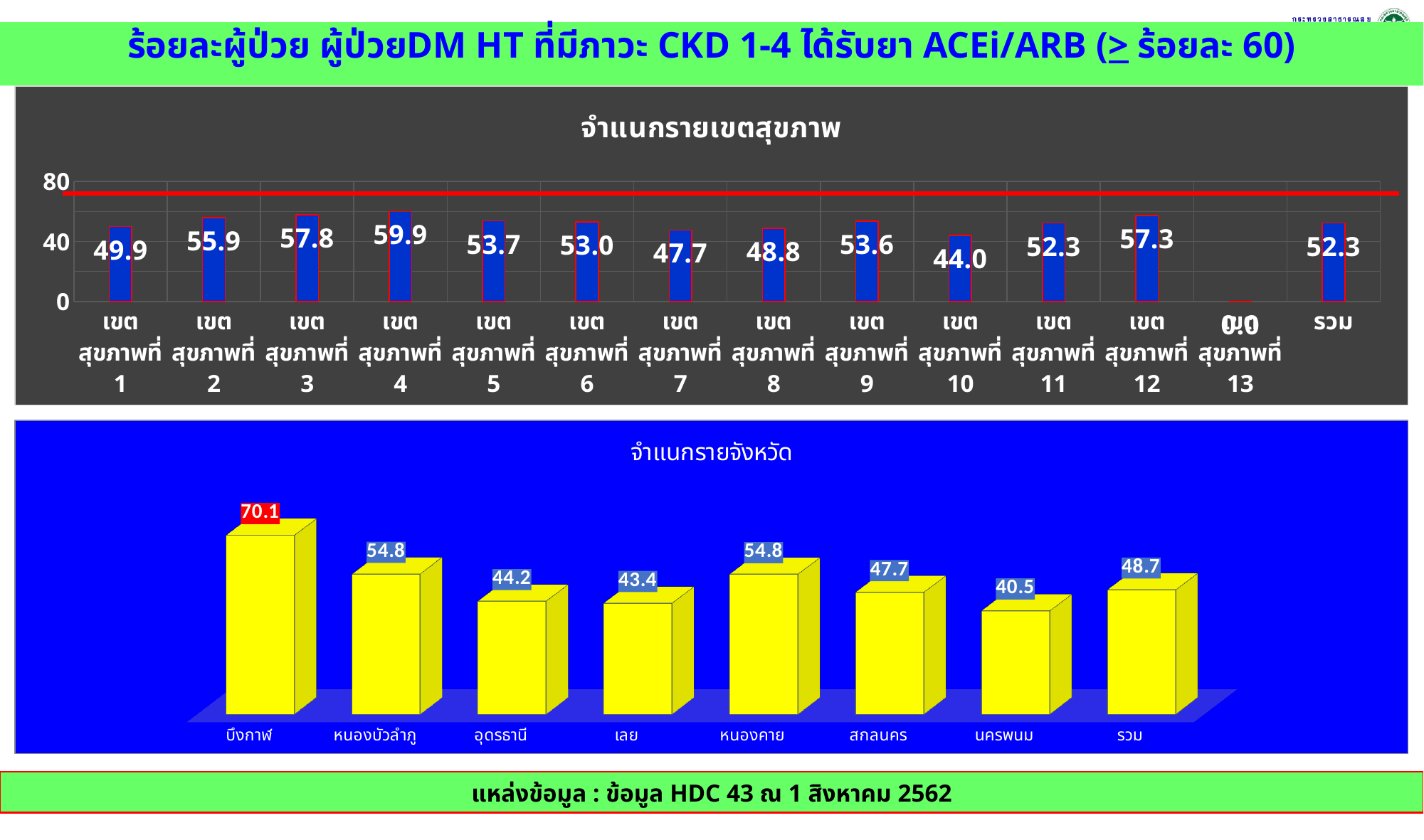
In the top chart (จำแนกรายเขตสุขภาพ), which health region (เขตสุขภาพที่ 1–12) has the lowest value? เขตสุขภาพที่ 10 In the top chart (จำแนกรายเขตสุขภาพ), what is the value for รวม? 52.3 In the bottom chart (จำแนกรายจังหวัด), which province has the lowest value? นครพนม In the bottom chart (จำแนกรายจังหวัด), which is larger, the value for อุดรธานี or the value for สกลนคร? สกลนคร In the top chart (จำแนกรายเขตสุขภาพ), what is the value for เขตสุขภาพที่ 10? 44.0 In the top chart (จำแนกรายเขตสุขภาพ), what is the value for เขตสุขภาพที่ 4? 59.9 What kind of chart is the bottom chart (จำแนกรายจังหวัด)? Bar chart In the bottom chart (จำแนกรายจังหวัด), what is the difference between the values for บึงกาฬ and นครพนม? 29.6 In the bottom chart (จำแนกรายจังหวัด), what is the value for บึงกาฬ? 70.1 In the top chart (จำแนกรายเขตสุขภาพ), which health region (เขตสุขภาพที่ 1–12) has the highest value? เขตสุขภาพที่ 4 In the bottom chart (จำแนกรายจังหวัด), how many bars are shown? 8 In the top chart (จำแนกรายเขตสุขภาพ), what is the difference between the values for เขตสุขภาพที่ 3 and เขตสุขภาพที่ 7? 10.1